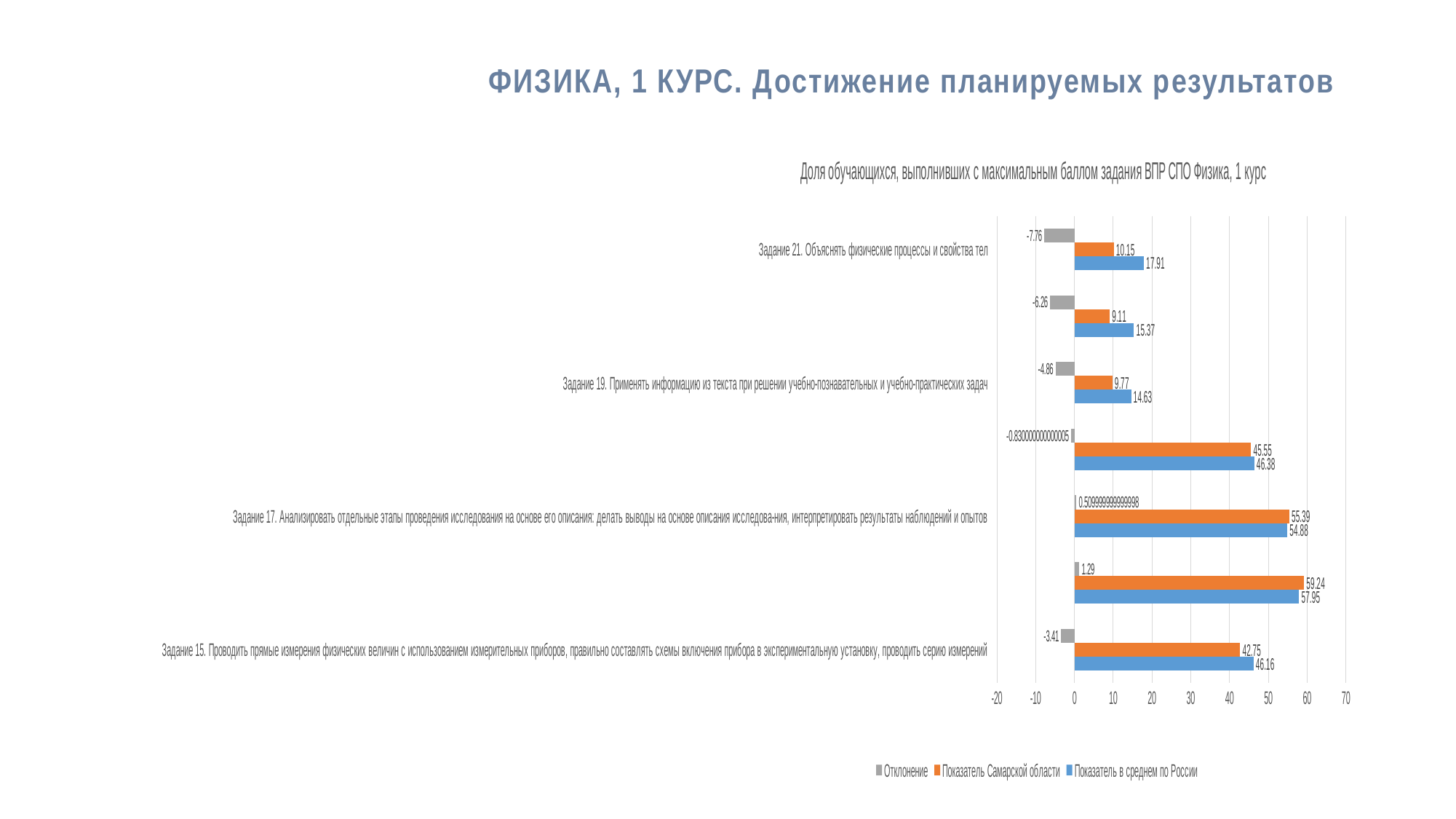
Among the labelled tasks, which has the lowest Показатель Самарской области? Задание 19 For Задание 15, which is larger: Показатель Самарской области or Показатель в среднем по России? Показатель в среднем по России What is the value of Показатель Самарской области for Задание 17? 55.39 What is the value of Показатель Самарской области for Задание 21? 10.15 What is the difference between Показатель в среднем по России and Показатель Самарской области for Задание 21? 7.76 What is the value of Показатель в среднем по России for Задание 15? 46.16 How many series does the legend list? 3 What colour represents the Отклонение series? Grey What kind of chart is shown on the slide? Bar chart Is the Показатель Самарской области for Задание 17 greater or less than 50? greater Among the labelled tasks, which has the highest Показатель в среднем по России? Задание 17 What is the Отклонение value for Задание 19? -4.86